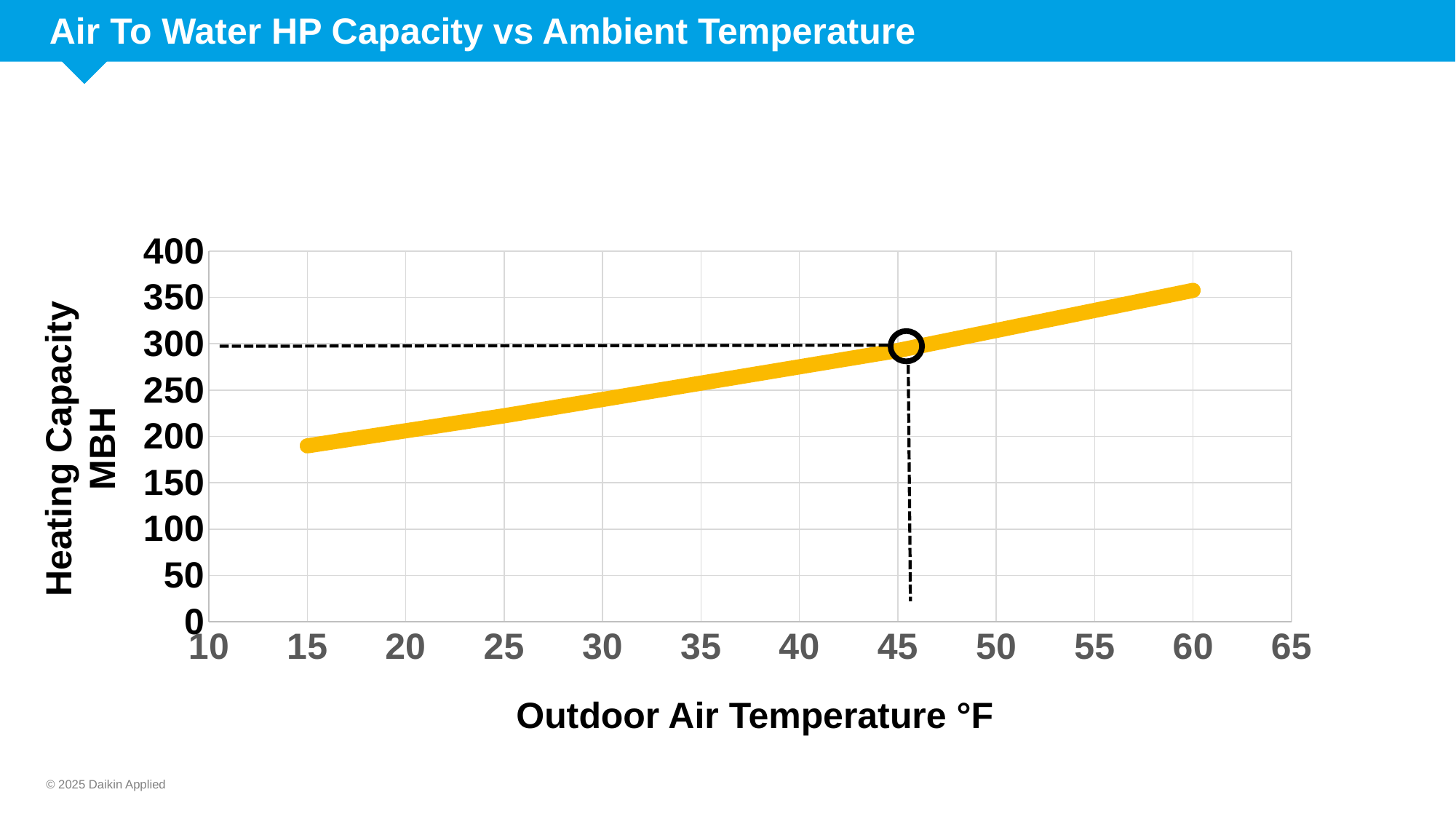
Which has the higher heating capacity: 20 °F or 55 °F outdoor air temperature? 55 °F Is the heating capacity at 15 °F outdoor air temperature greater or less than 150 MBH? greater What kind of chart is shown on the slide? line chart How many lines are plotted on the chart? 1 Is the heating capacity at 30 °F outdoor air temperature greater or less than 200 MBH? greater Does heating capacity rise or fall as outdoor air temperature increases? rise What is the label of the x axis? Outdoor Air Temperature °F Is the outdoor air temperature at the circled point greater or less than 40 °F? greater What is the label of the y axis? Heating Capacity MBH